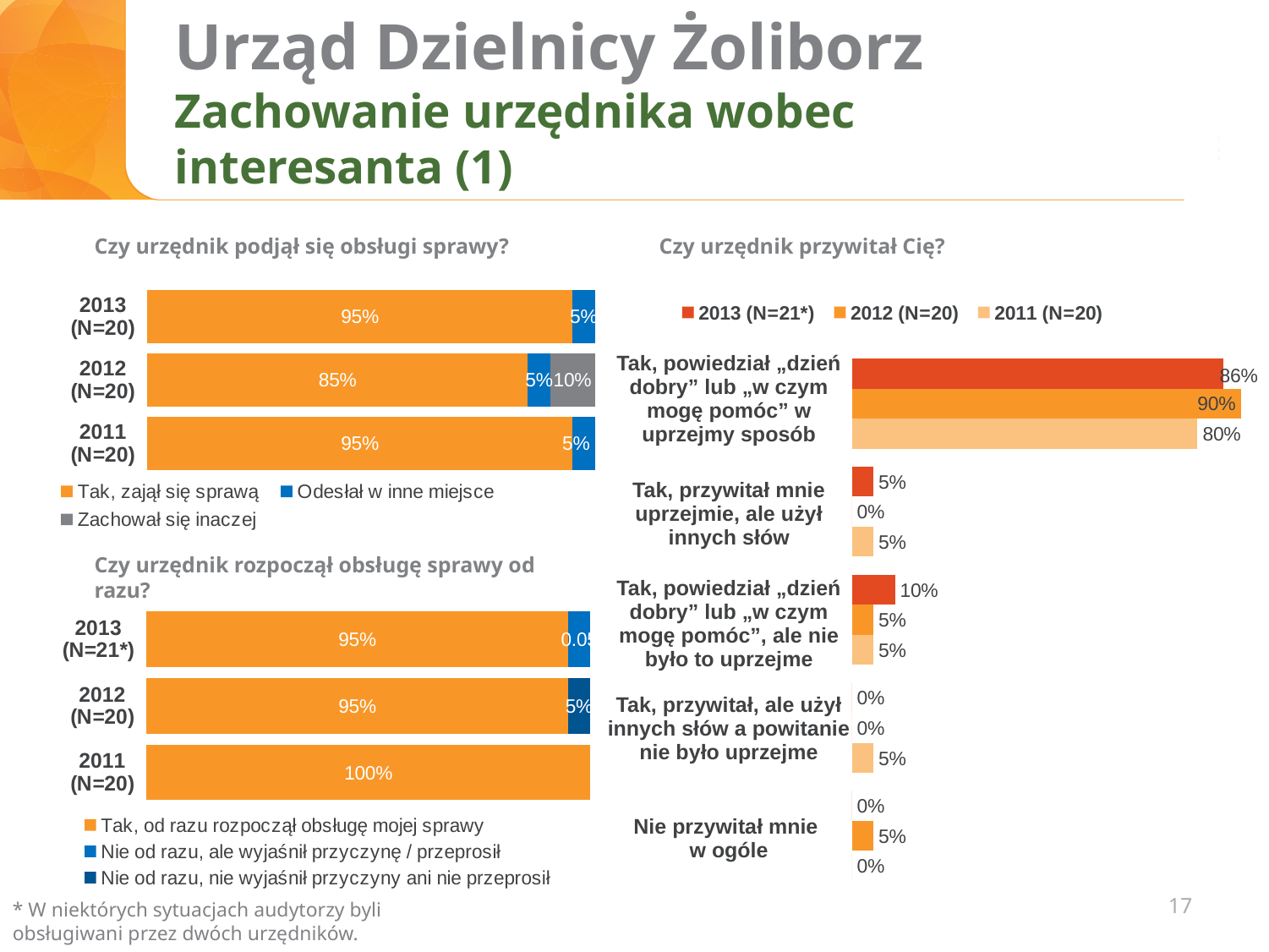
In the chart "Czy urzędnik podjął się obsługi sprawy?", what is the value of "Tak, zajął się sprawą" for 2012 (N=20)? 85% What kind of chart is "Czy urzędnik rozpoczął obsługę sprawy od razu?"? Stacked bar chart In the chart "Czy urzędnik podjął się obsługi sprawy?", which year has the lowest value for "Tak, zajął się sprawą"? 2012 (N=20) In the chart "Czy urzędnik przywitał Cię?", which year has the highest value for "Tak, powiedział „dzień dobry” lub „w czym mogę pomóc” w uprzejmy sposób"? 2012 (N=20) In the chart "Czy urzędnik przywitał Cię?", how many response categories are shown? 5 In the chart "Czy urzędnik podjął się obsługi sprawy?", what percentage for 2012 (N=20) is "Zachował się inaczej"? 10% In the chart "Czy urzędnik przywitał Cię?", what is the 2013 (N=21*) value for "Tak, powiedział „dzień dobry” lub „w czym mogę pomóc” w uprzejmy sposób"? 86% In the chart "Czy urzędnik przywitał Cię?", what is the 2013 (N=21*) value for "Tak, powiedział „dzień dobry” lub „w czym mogę pomóc”, ale nie było to uprzejme"? 10% In the chart "Czy urzędnik przywitał Cię?", what is the difference between the 2012 (N=20) and 2011 (N=20) values for "Tak, powiedział „dzień dobry” lub „w czym mogę pomóc” w uprzejmy sposób"? 10% In the chart "Czy urzędnik rozpoczął obsługę sprawy od razu?", what is the value of "Nie od razu, nie wyjaśnił przyczyny ani nie przeprosił" for 2012 (N=20)? 5% In the chart "Czy urzędnik rozpoczął obsługę sprawy od razu?", what is the value of "Tak, od razu rozpoczął obsługę mojej sprawy" for 2011 (N=20)? 100% In the chart "Czy urzędnik podjął się obsługi sprawy?", how many series does the legend list? 3